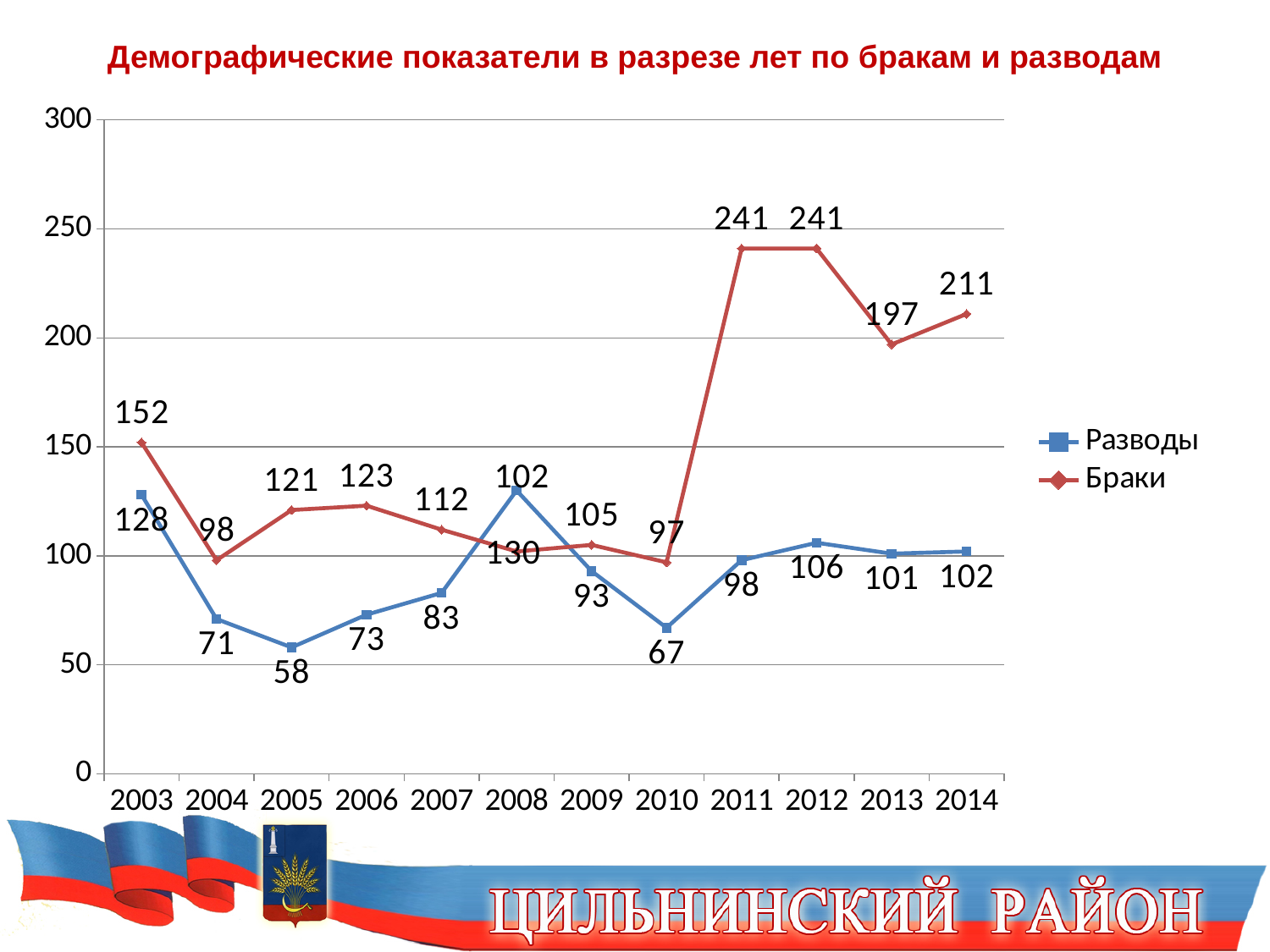
What are the two entries in the chart legend? Разводы and Браки What is the difference between the Браки value in 2011 and in 2013? 44 In which year is the Разводы series at its lowest? 2005 What is the value for Браки in 2003? 152 In which year is the Браки series at its lowest? 2010 What is the value for Разводы in 2005? 58 What kind of chart is shown on the slide? Line chart What is the value for Браки in 2014? 211 Does the Разводы series rise or fall from 2003 to 2005? Fall How many series does the legend list? 2 In 2012, which series has the larger value, Браки or Разводы? Браки How many years are shown on the x axis? 12